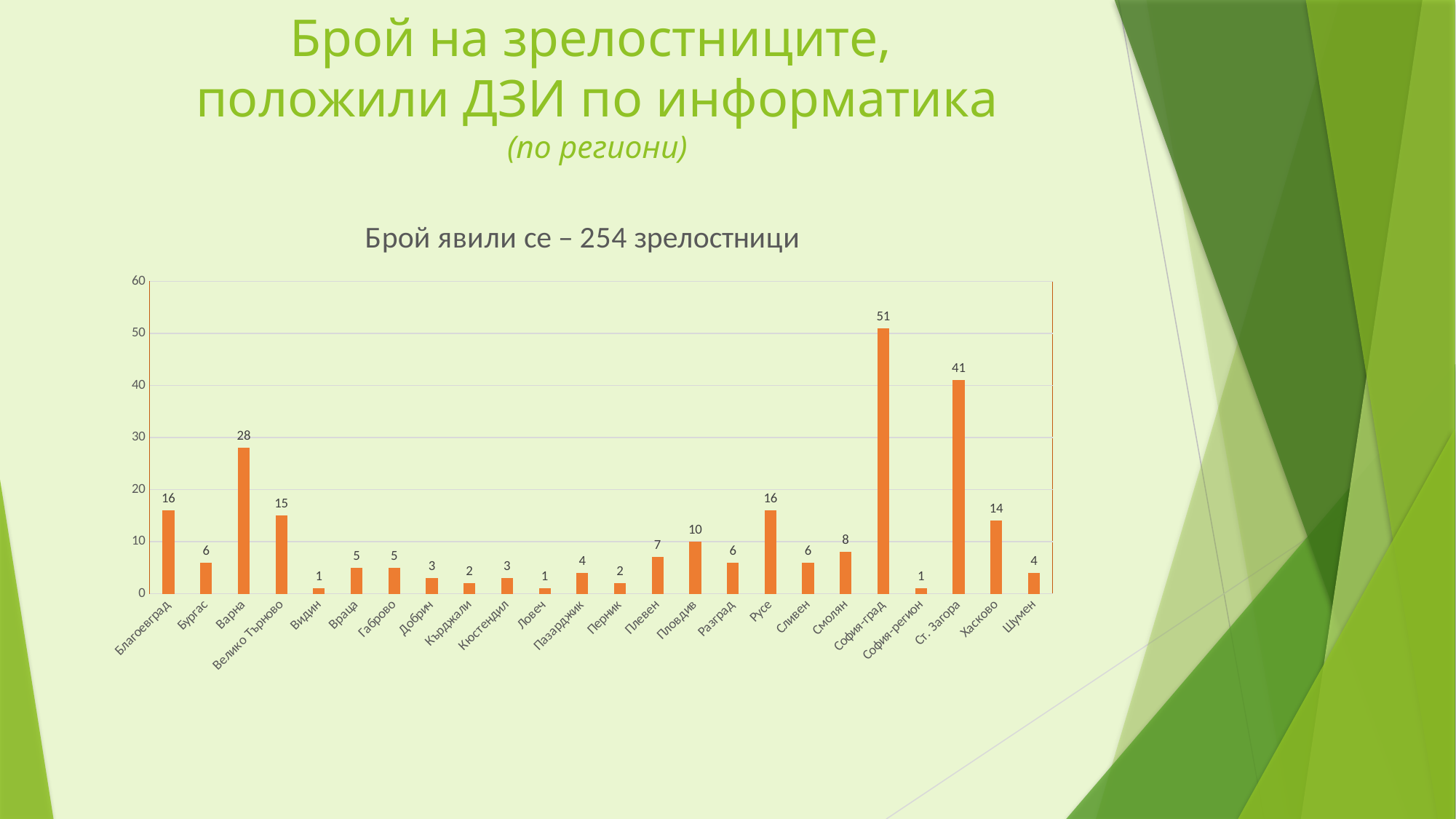
What is the value for Варна? 28 What is the value for Хасково? 14 Which is larger, the value for Русе or the value for Смолян? Русе Is the value for Ст. Загора greater or less than 30? greater What is the title of the chart? Брой явили се – 254 зрелостници Which region has the highest value? София-град What is the value for Пловдив? 10 What is the value for София-град? 51 What is the difference between the values for София-град and Ст. Загора? 10 What type of chart is shown on the slide? bar chart How many regions are shown on the x axis? 24 What is the difference between the values for Варна and Велико Търново? 13